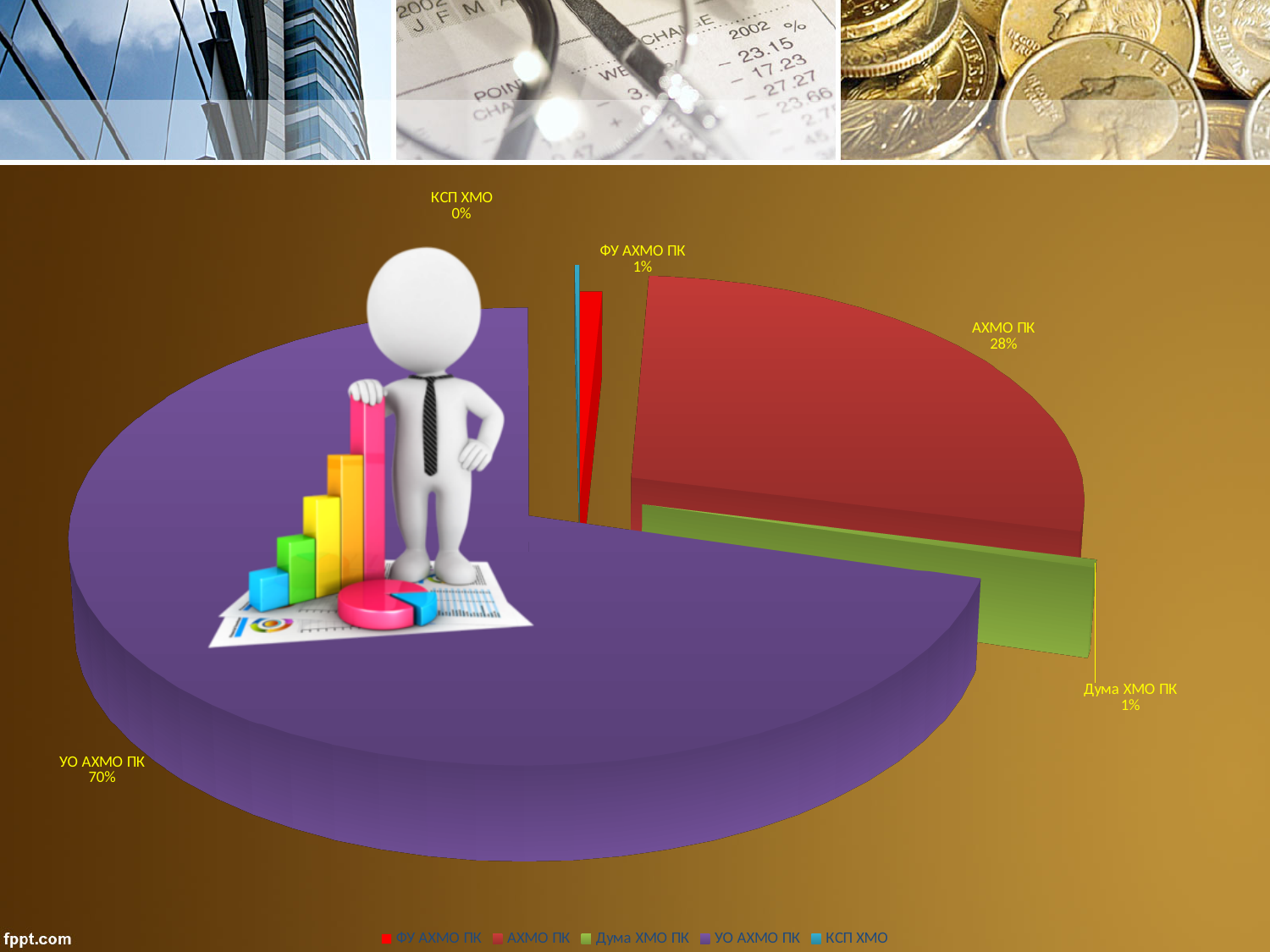
What share of the pie does УО АХМО ПК have? 70% What kind of chart is shown on the slide? pie chart Which category has the largest slice of the pie? УО АХМО ПК How many categories does the pie chart show? 5 Which category has the smallest slice of the pie? КСП ХМО Which is larger, the share for АХМО ПК or the share for Дума ХМО ПК? АХМО ПК What is the difference in percentage points between УО АХМО ПК and АХМО ПК? 42 What share of the pie does АХМО ПК have? 28% What share of the pie does Дума ХМО ПК have? 1% What colour is the slice for УО АХМО ПК? purple What share of the pie does КСП ХМО have? 0% What share of the pie does ФУ АХМО ПК have? 1%